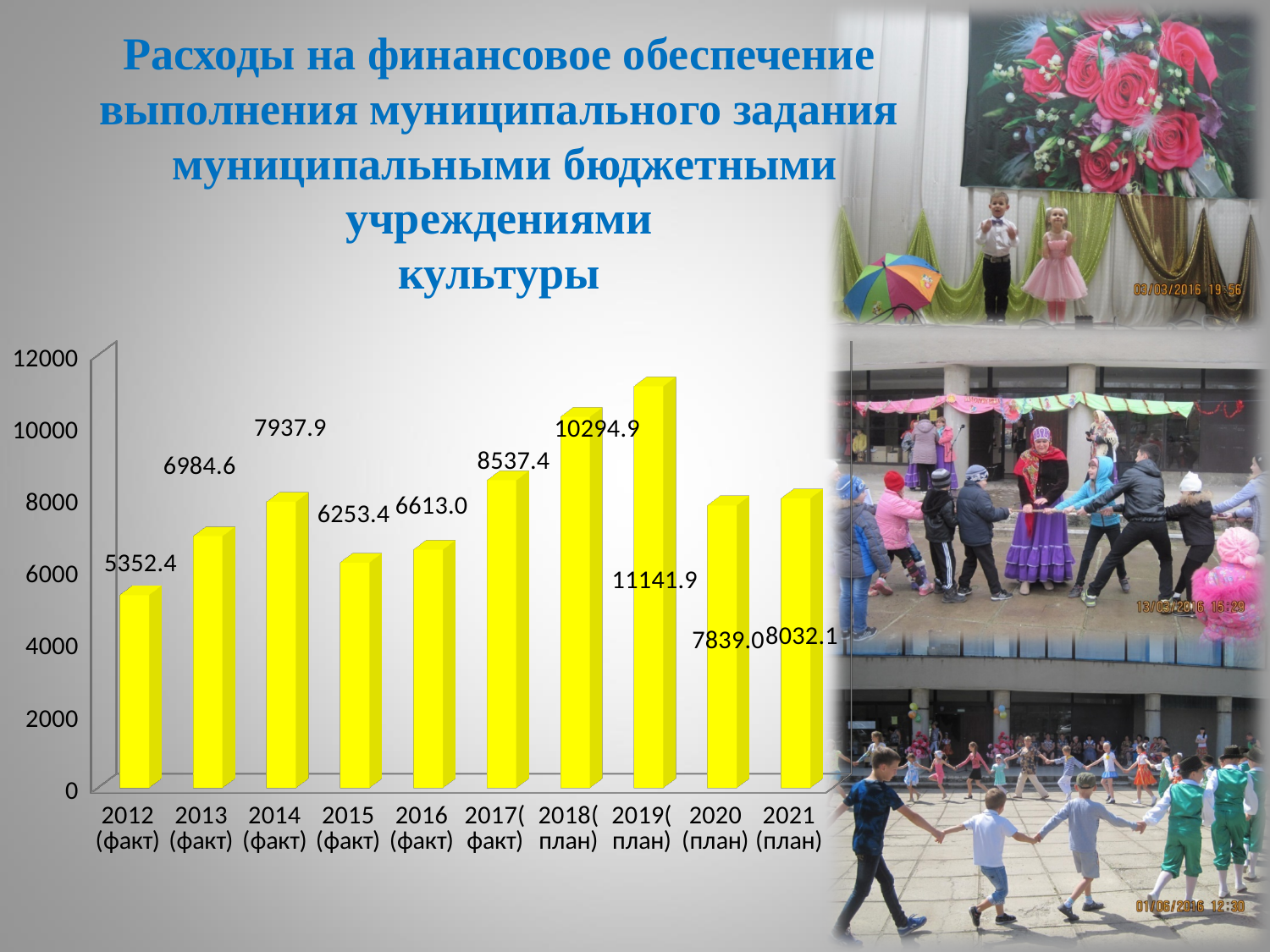
Do the values rise or fall from 2012 (факт) to 2014 (факт)? rise How many categories are shown on the x axis? 10 Which is larger, the value for 2017 (факт) or the value for 2016 (факт)? 2017 (факт) Is the value for 2018 (план) greater or less than 10000? greater What is the value for 2012 (факт)? 5352.4 What is the difference between the values for 2019 (план) and 2018 (план)? 847.0 What is the value for 2018 (план)? 10294.9 What kind of chart is shown on the slide? bar chart Which category has the lowest value? 2012 (факт) Which category has the highest value? 2019 (план) What is the value for 2016 (факт)? 6613.0 What is the difference between the values for 2013 (факт) and 2012 (факт)? 1632.2